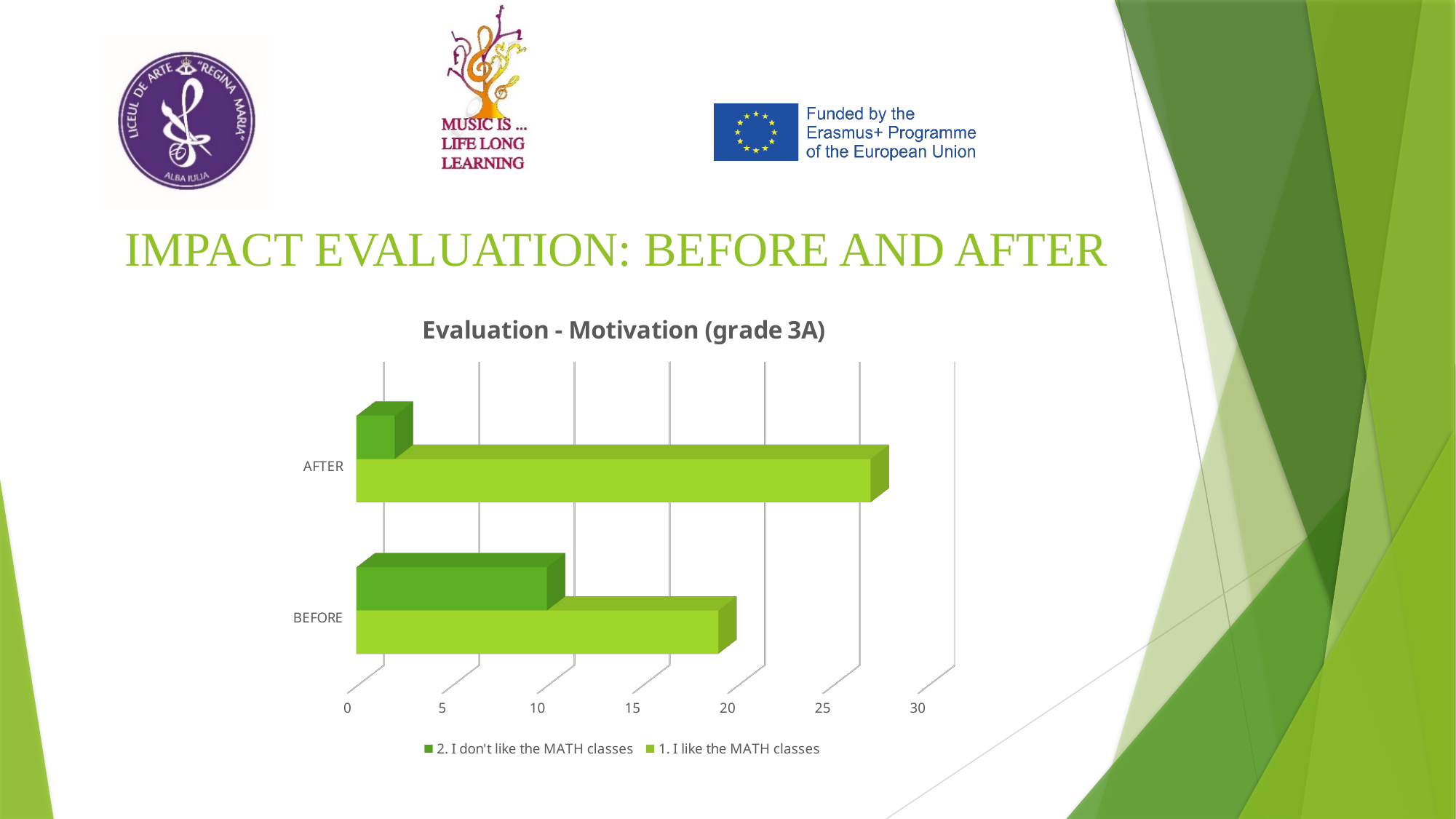
How many categories are shown on the vertical axis? 2 Is the AFTER value for "2. I don't like the MATH classes" greater or less than 5? less What is the title of the chart? Evaluation - Motivation (grade 3A) Which category has the longer bar for "2. I don't like the MATH classes", BEFORE or AFTER? BEFORE How many series does the legend list? 2 What kind of chart is shown on the slide? bar chart Which category has the longer bar for "1. I like the MATH classes", BEFORE or AFTER? AFTER Is the BEFORE value for "2. I don't like the MATH classes" greater or less than 15? less Which category has the lowest value for "2. I don't like the MATH classes"? AFTER Is the AFTER value for "1. I like the MATH classes" greater or less than 20? greater In the BEFORE category, which series has the larger value? 1. I like the MATH classes